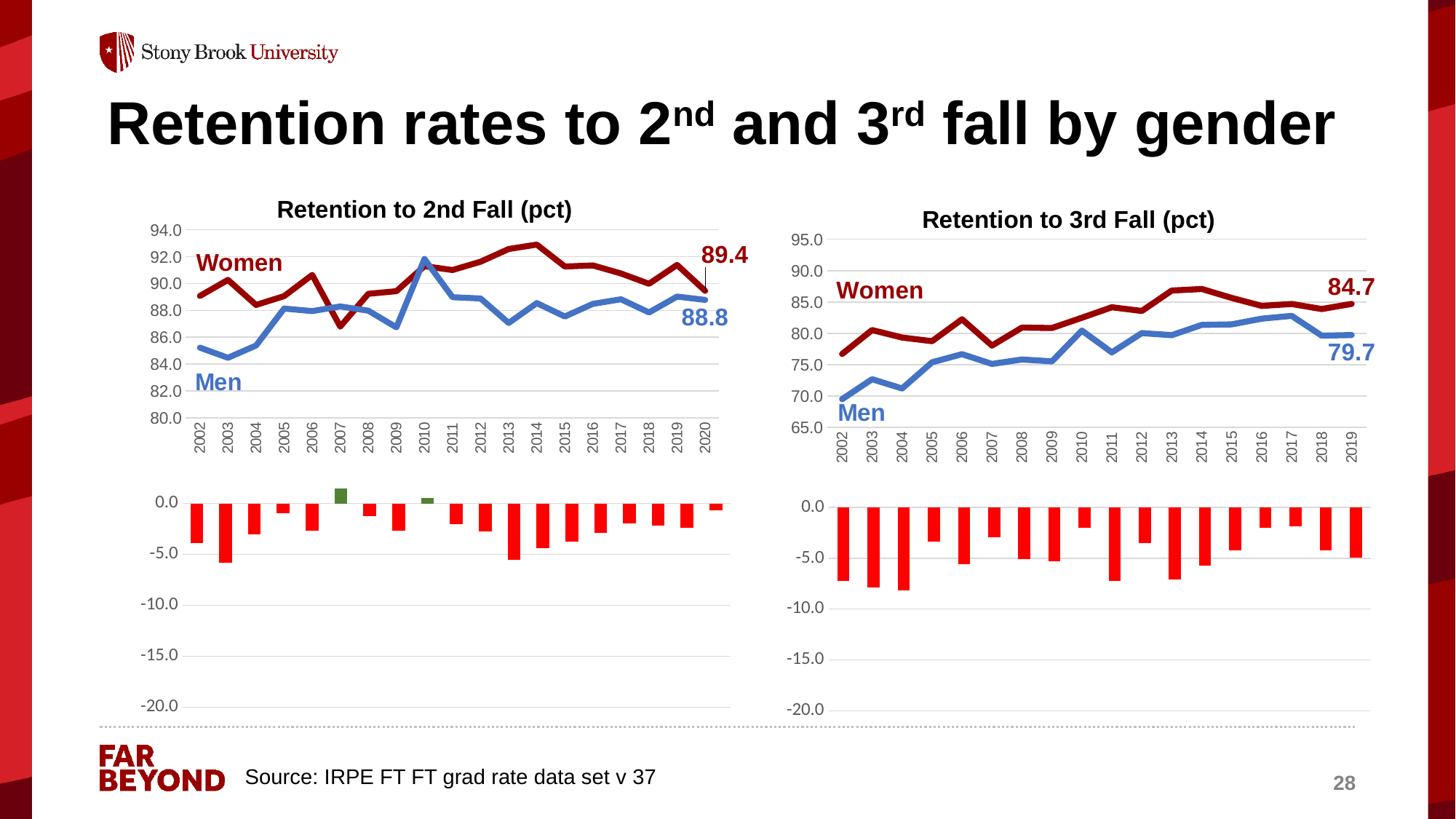
In the Retention to 3rd Fall (pct) chart, what is the difference between the labelled 2019 values for Women and Men? 5.0 In the Retention to 3rd Fall (pct) chart, which series has the higher value in 2019, Women or Men? Women In the Retention to 3rd Fall (pct) chart, what is the labelled value for Men in 2019? 79.7 In the Retention to 2nd Fall (pct) chart, what is the labelled value for Men in 2020? 88.8 How many years are shown on the x axis of the Retention to 3rd Fall (pct) chart? 18 In the Retention to 3rd Fall (pct) chart, is the value for Men in 2002 greater or less than 75.0? less In the Retention to 2nd Fall (pct) chart, what is the labelled value for Women in 2020? 89.4 In the Retention to 2nd Fall (pct) chart, what is the difference between the labelled 2020 values for Women and Men? 0.6 In the Retention to 3rd Fall (pct) chart, does the Men series generally rise or fall from 2002 to 2019? Rise In the Retention to 3rd Fall (pct) chart, what is the labelled value for Women in 2019? 84.7 In the Retention to 2nd Fall (pct) chart, is the value for Men in 2002 greater or less than 86.0? less What type of chart is the Retention to 2nd Fall (pct) chart? Line chart